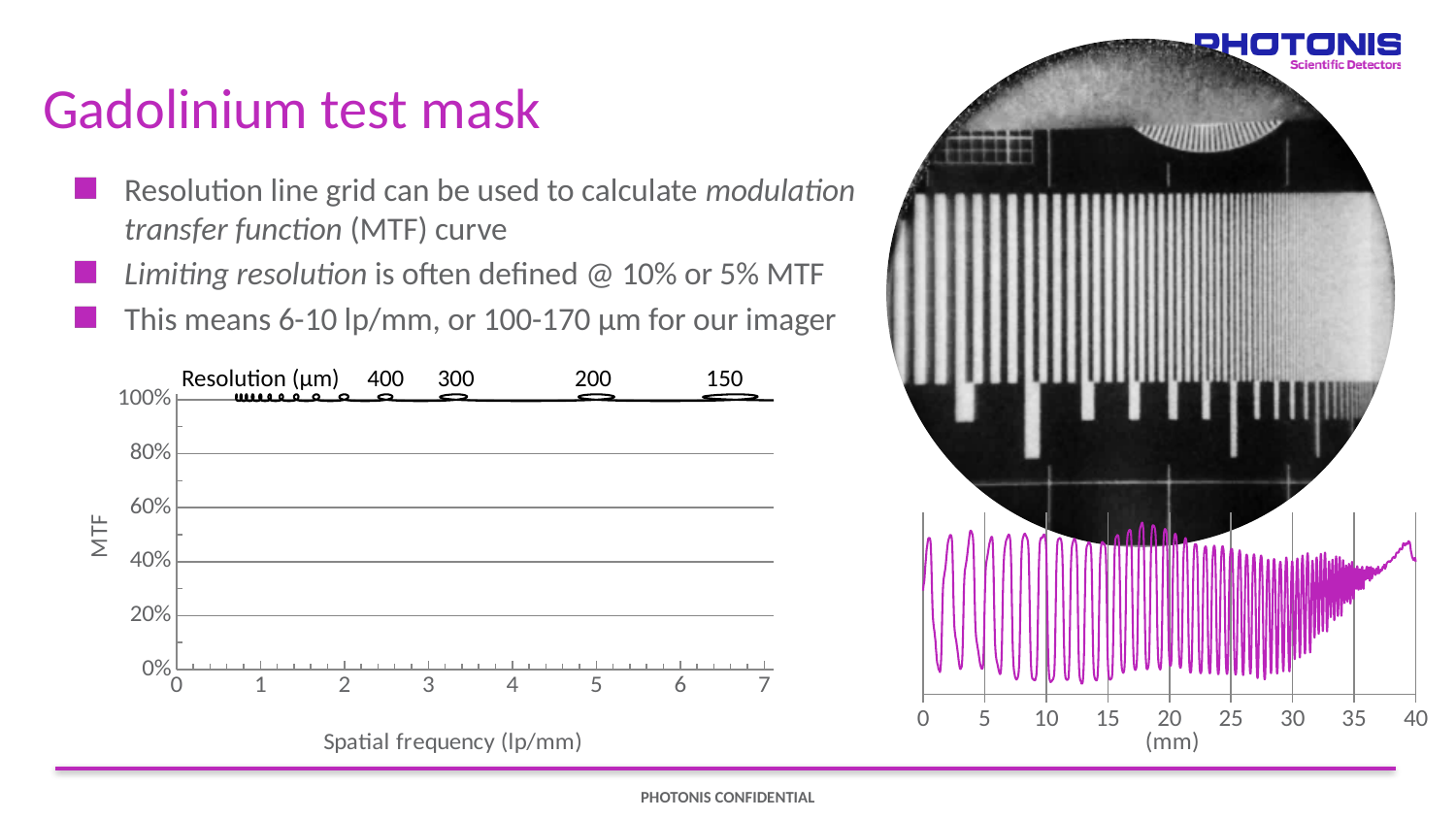
On the MTF chart, what label is given to the secondary axis along the top? Resolution (µm) On the MTF chart, how many labelled tick values are shown on the vertical MTF axis? 6 On the chart on the right, what is the highest value labelled on the (mm) axis? 40 What kind of chart is the chart on the right of the slide, plotted against (mm)? line chart On the MTF chart, is the plotted MTF value at a spatial frequency of 1 lp/mm greater or less than 80%? greater On the chart on the right, how many labelled tick values are shown on the (mm) axis? 9 On the MTF chart, does the plotted curve rise, fall, or stay flat as spatial frequency increases from 0 to 7 lp/mm? stay flat On the MTF chart, what is the highest value labelled on the spatial frequency axis? 7 On the chart on the right, does the amplitude of the oscillating line rise or fall as the (mm) value increases from 0 to 35? fall On the MTF chart, what is the label of the horizontal axis? Spatial frequency (lp/mm) On the MTF chart, is the plotted MTF value at a spatial frequency of 5 lp/mm greater or less than 60%? greater